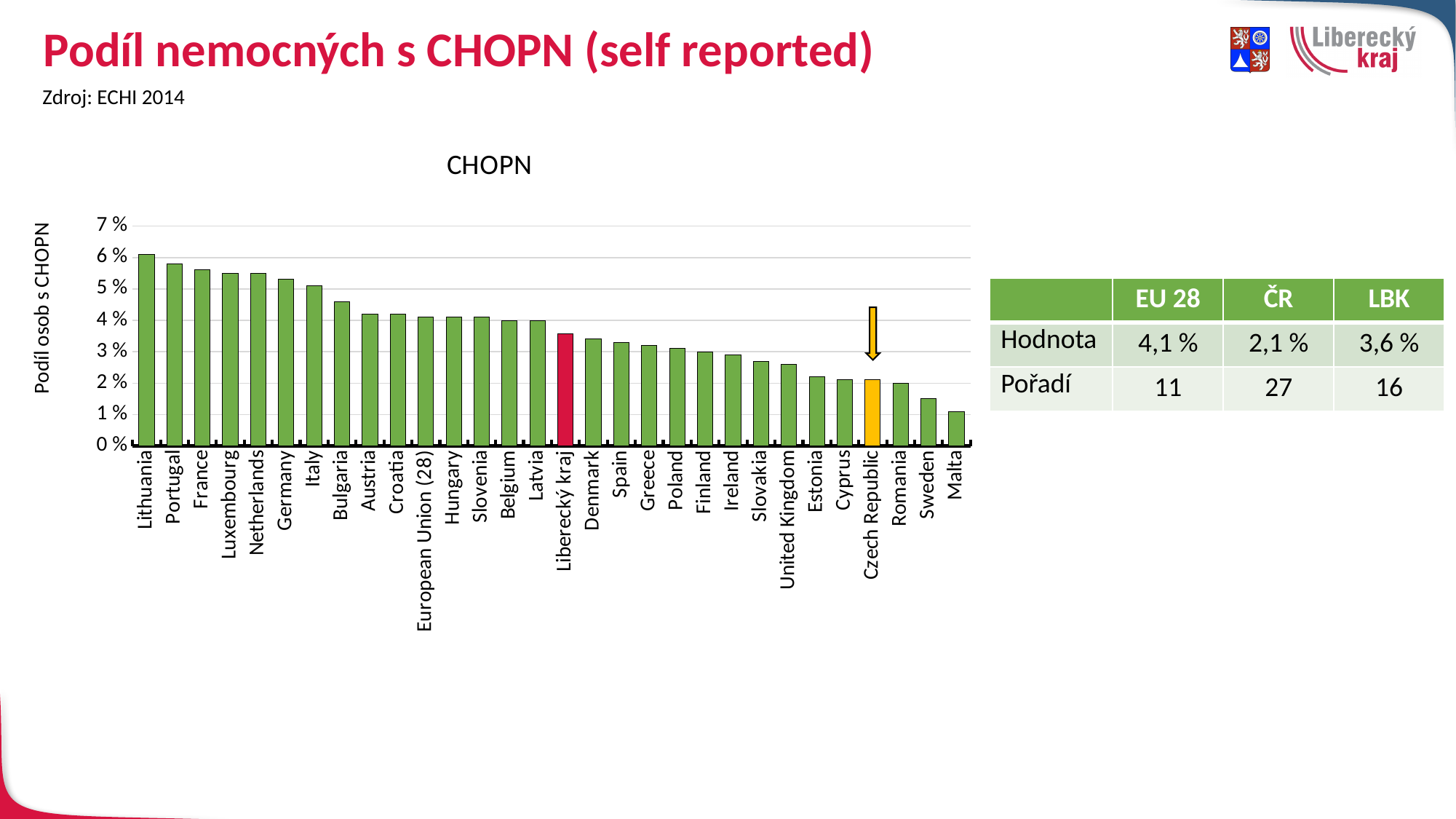
Which category has the highest value in the CHOPN chart? Lithuania Which has the larger value, Germany or Denmark? Germany Which category has the lowest value in the CHOPN chart? Malta Is the value for Sweden greater or less than 2 %? less What is the value for European Union (28) in the CHOPN chart? 4,1 % Do the values rise or fall from left to right along the x axis? fall What is the value for Czech Republic in the CHOPN chart? 2,1 % What is the difference between the values for Liberecký kraj and Czech Republic? 1,5 % What is the value for Liberecký kraj in the CHOPN chart? 3,6 % How many categories (bars) does the CHOPN chart show? 30 Is the value for Bulgaria greater or less than 5 %? less What kind of chart is shown on the slide? bar chart